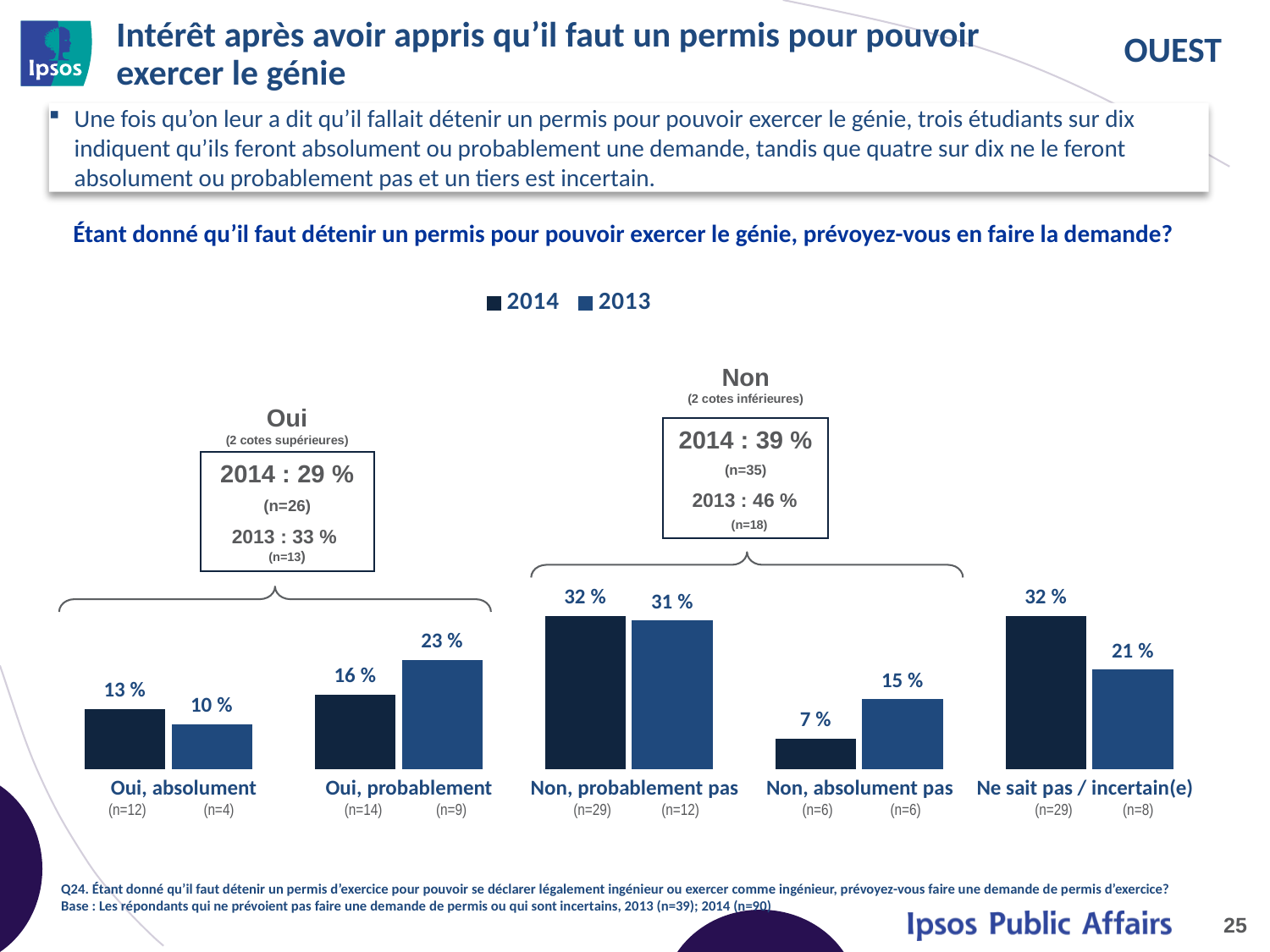
What is the 2013 value for "Non, absolument pas"? 15 % How many series does the legend list? 2 Which category has the lowest 2014 value? Non, absolument pas What is the difference between the 2013 and 2014 values for "Ne sait pas / incertain(e)"? 11 % Which series is shown in the darker navy colour? 2014 Which category has the highest 2013 value? Non, probablement pas How many response categories are shown on the x axis? 5 What kind of chart is shown on the slide? Bar chart What is the 2014 value for "Oui, absolument"? 13 % What is the 2014 value for "Ne sait pas / incertain(e)"? 32 % For "Oui, probablement", which year has the larger value, 2014 or 2013? 2013 What is the 2013 value for "Oui, probablement"? 23 %